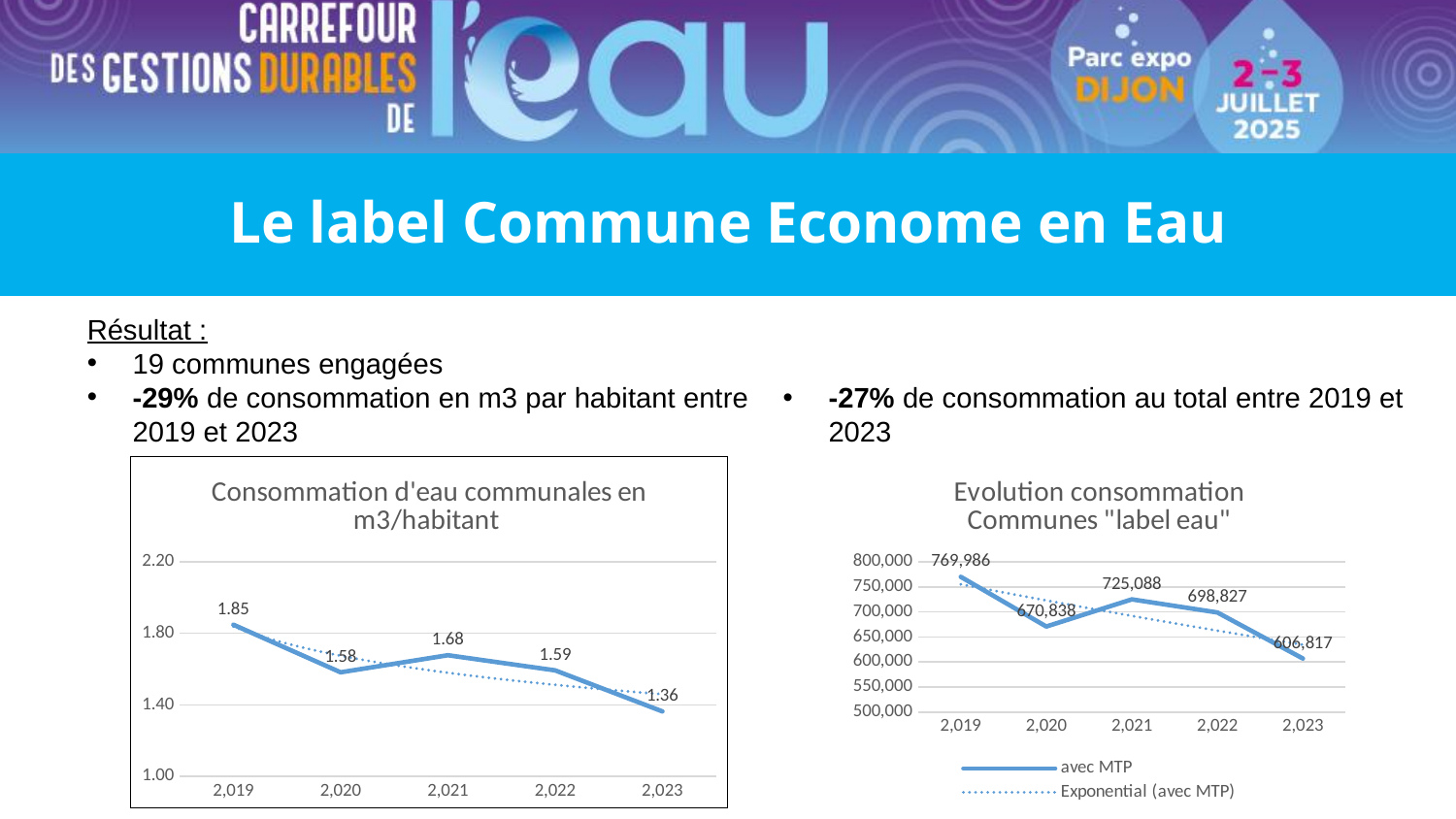
In the chart 'Evolution consommation Communes "label eau"', what is the value for 2021? 725,088 In the chart 'Evolution consommation Communes "label eau"', which year has the lowest value? 2023 In the chart 'Consommation d'eau communales en m3/habitant', what is the value for 2023? 1.36 In the chart 'Evolution consommation Communes "label eau"', is the value for 2022 greater or less than 650,000? greater In the chart 'Consommation d'eau communales en m3/habitant', what is the value for 2019? 1.85 In the chart 'Evolution consommation Communes "label eau"', what is the difference between the 2019 value and the 2020 value? 99,148 In the chart 'Consommation d'eau communales en m3/habitant', how many years are plotted? 5 In the chart 'Consommation d'eau communales en m3/habitant', what is the difference between the 2019 value and the 2023 value? 0.49 What kind of chart is 'Evolution consommation Communes "label eau"'? Line chart How many entries does the legend of the chart 'Evolution consommation Communes "label eau"' list? 2 In the chart 'Consommation d'eau communales en m3/habitant', is the value for 2021 larger than the value for 2022? Yes In the chart 'Consommation d'eau communales en m3/habitant', which year has the highest value? 2019